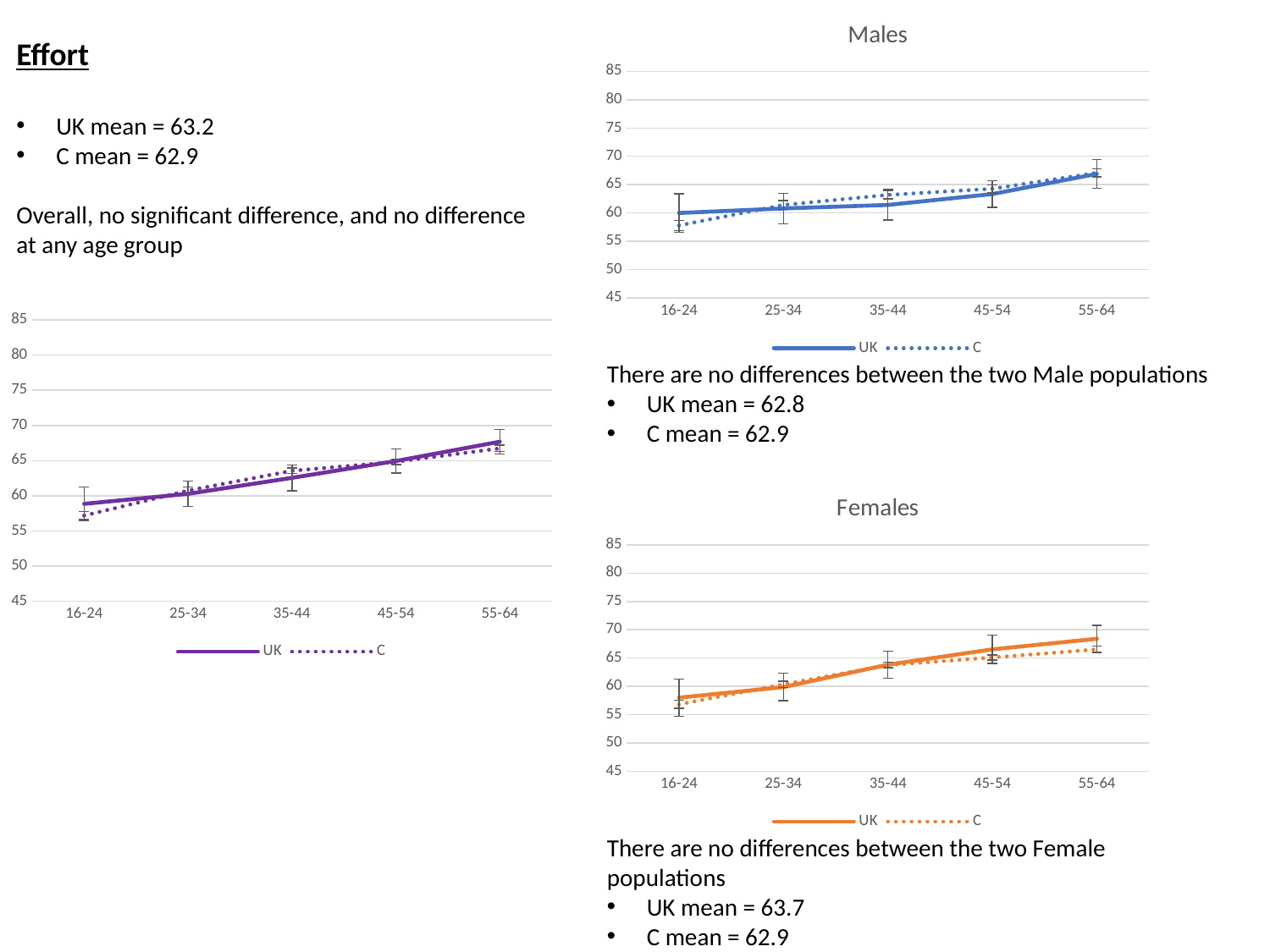
What is the title of the chart at the top right of the slide? Males What are the two legend entries in the 'Females' chart? UK and C What kind of chart is the 'Males' chart? line chart In the 'Females' chart, which age group has the highest UK value? 55-64 In the 'Males' chart, is the UK value for the 55-64 group greater or less than 65? greater In the 'Males' chart, which is larger for the UK series: the value for 55-64 or the value for 16-24? 55-64 In the chart on the left of the slide, is the UK value for the 55-64 group greater or less than 65? greater In the 'Females' chart, do the UK values rise or fall from the 16-24 group to the 55-64 group? rise In the 'Females' chart, is the UK value for the 16-24 group greater or less than 60? less How many series does the legend of the 'Males' chart list? 2 How many age-group categories are shown on the x axis of the 'Females' chart? 5